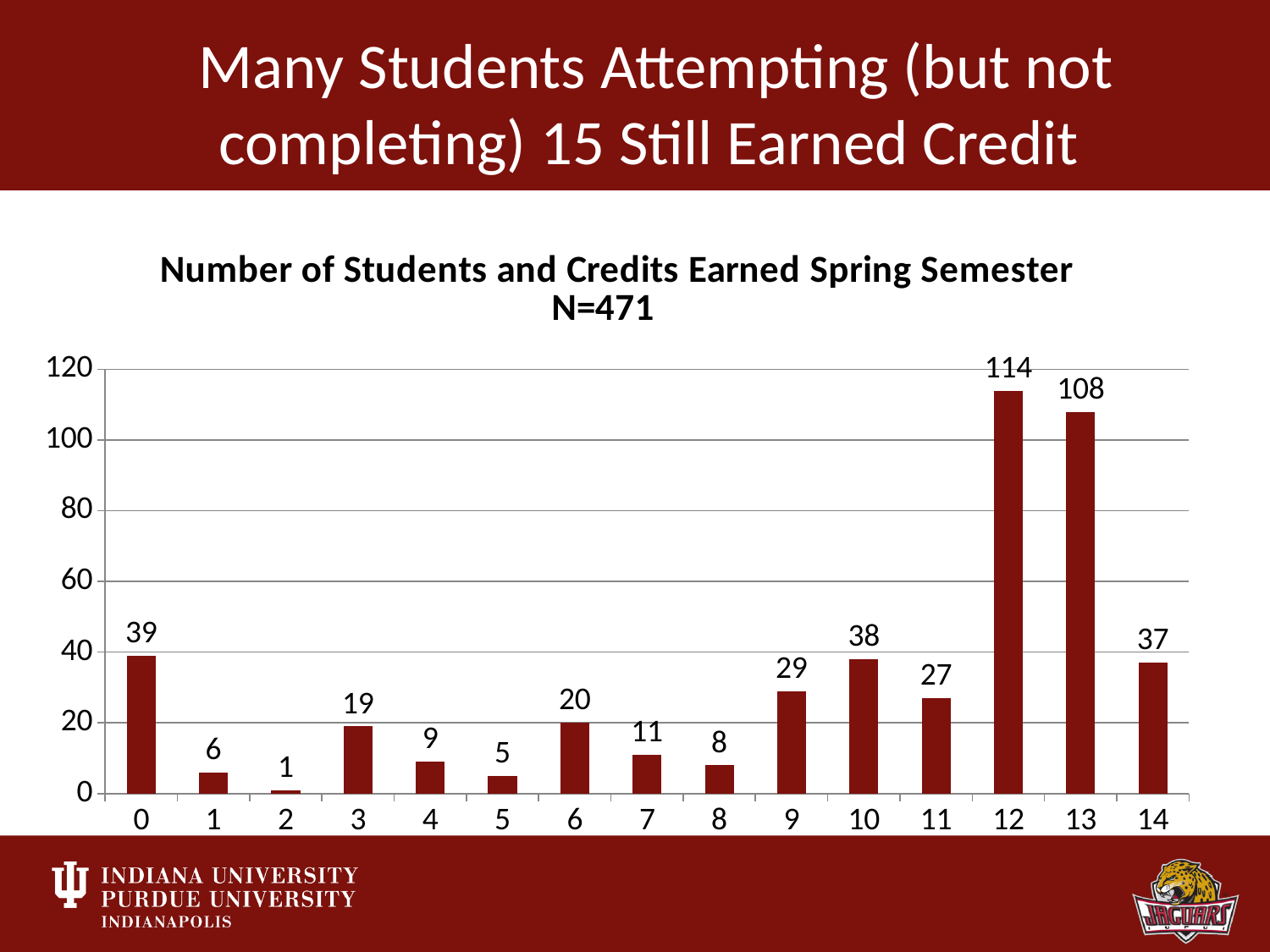
What is the difference between the values for categories 12 and 13? 6 How many categories are shown on the x axis? 15 What is the difference between the values for categories 0 and 14? 2 Which is larger, the value for category 9 or the value for category 11? 9 What kind of chart is shown? bar chart Is the value for category 10 greater or less than 20? greater Which category has the lowest value? 2 What is the value for category 12? 114 Which category has the highest value? 12 What is the value for category 0? 39 What is the value for category 7? 11 What is the title of the chart? Number of Students and Credits Earned Spring Semester N=471